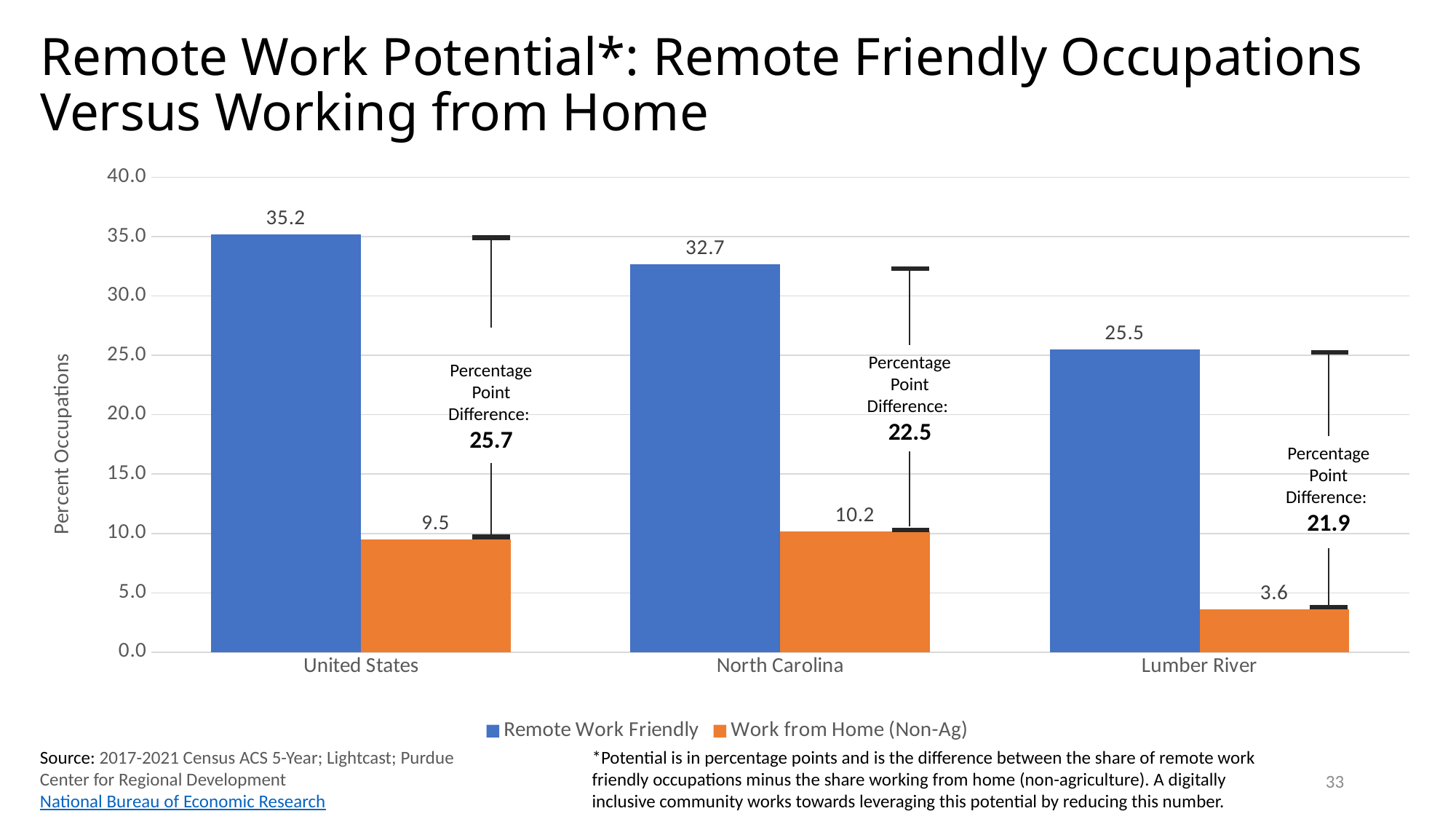
What is the label of the y axis? Percent Occupations What is the difference between the Remote Work Friendly values for the United States and Lumber River? 9.7 What is the Remote Work Friendly value for the United States? 35.2 How many regions are shown on the x axis? 3 Which is larger: the Work from Home (Non-Ag) value for the United States or for North Carolina? North Carolina Which region has the highest Remote Work Friendly value? United States Which region has the lowest Work from Home (Non-Ag) value? Lumber River What is the difference between the Remote Work Friendly and Work from Home (Non-Ag) values for North Carolina? 22.5 How many series does the legend list? 2 What is the Work from Home (Non-Ag) value for North Carolina? 10.2 What kind of chart is shown on the slide? Bar chart What is the Work from Home (Non-Ag) value for Lumber River? 3.6